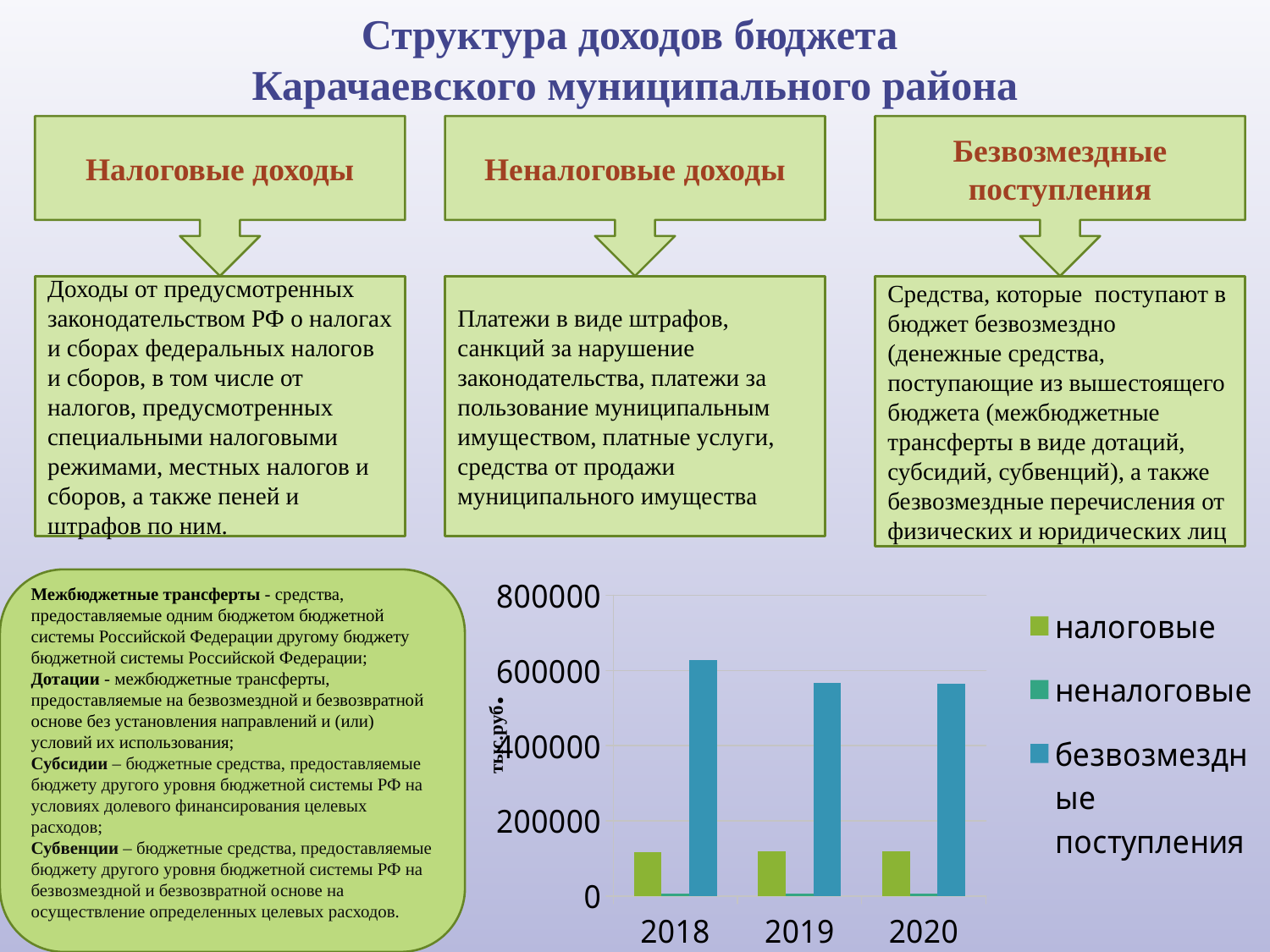
Which series has the lowest value in 2020? неналоговые Is the value for безвозмездные поступления in 2019 greater or less than 600000? less What kind of chart is shown on the slide? bar chart What unit is shown on the vertical axis label of the chart? тыс.руб. Did the value for безвозмездные поступления rise or fall from 2018 to 2019? fall How many series does the chart legend list? 3 Is the value for налоговые in 2018 greater or less than 200000? less Is the value for безвозмездные поступления in 2018 greater or less than 600000? greater Which series has the highest value in 2018? безвозмездные поступления How many years are shown on the x axis of the chart? 3 Which is larger in 2019: налоговые or безвозмездные поступления? безвозмездные поступления